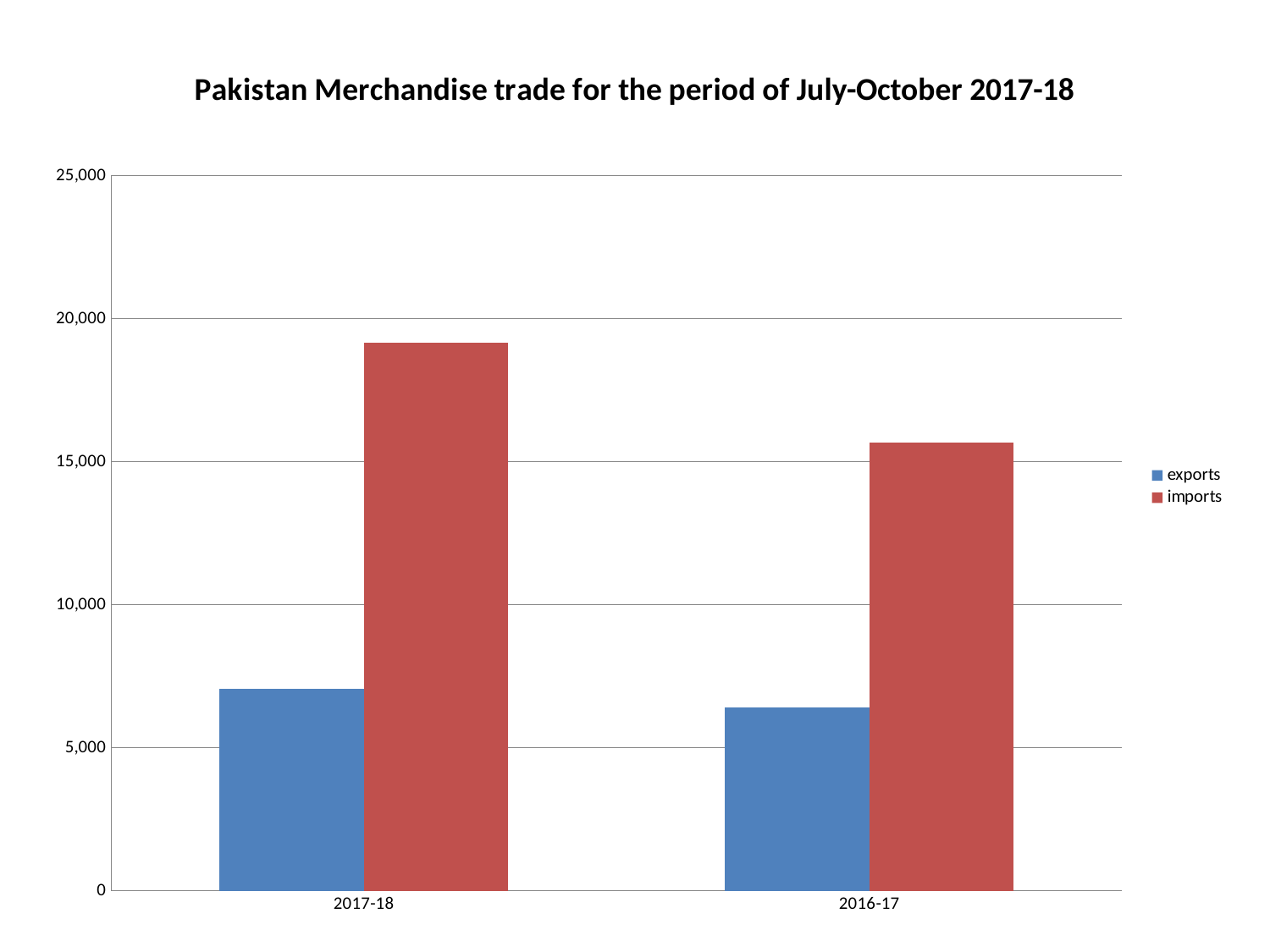
How many series does the legend list? 2 Which is larger in 2016-17, exports or imports? imports Is the value for exports in 2016-17 greater or less than 10,000? less Is the value for imports in 2016-17 greater or less than 15,000? greater Is the value for imports in 2017-18 greater or less than 15,000? greater What kind of chart is shown on the slide? bar chart Which series is shown in red? imports What is the title of the chart? Pakistan Merchandise trade for the period of July-October 2017-18 Which is larger, imports in 2017-18 or imports in 2016-17? imports in 2017-18 How many categories are shown on the x axis? 2